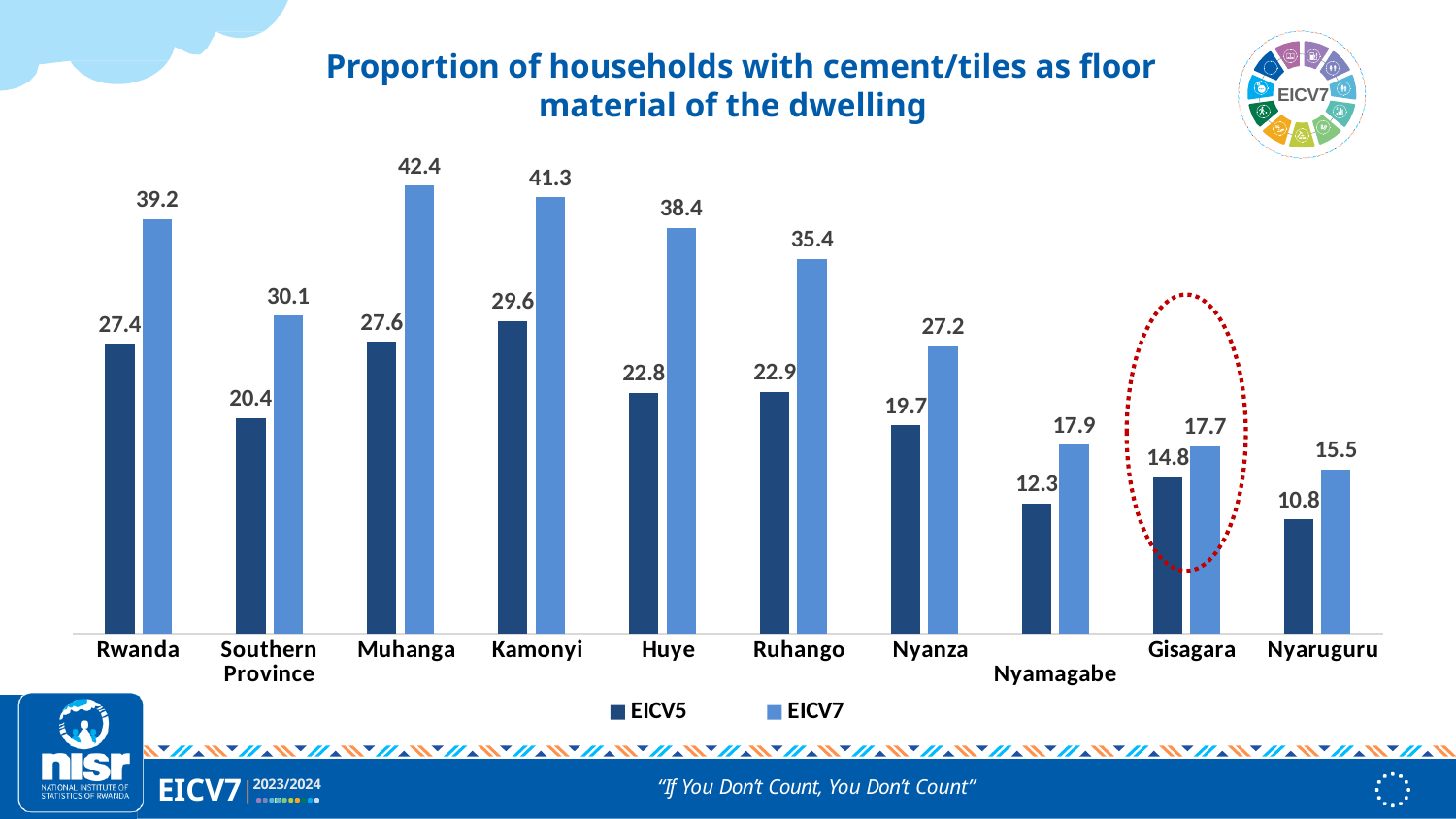
Which is larger, the EICV5 value for Gisagara or the EICV5 value for Nyamagabe? Gisagara Which category has the highest EICV7 value? Muhanga What is the difference between the EICV7 values for Kamonyi and Huye? 2.9 Which category is highlighted with a red dotted circle? Gisagara How many categories are shown on the x axis? 10 What is the EICV7 value for Muhanga? 42.4 How many series does the legend list? 2 What is the EICV7 value for Southern Province? 30.1 What is the EICV5 value for Nyaruguru? 10.8 Which category has the lowest EICV5 value? Nyaruguru What is the difference between the EICV7 and EICV5 values for Rwanda? 11.8 What kind of chart is shown on the slide? Bar chart